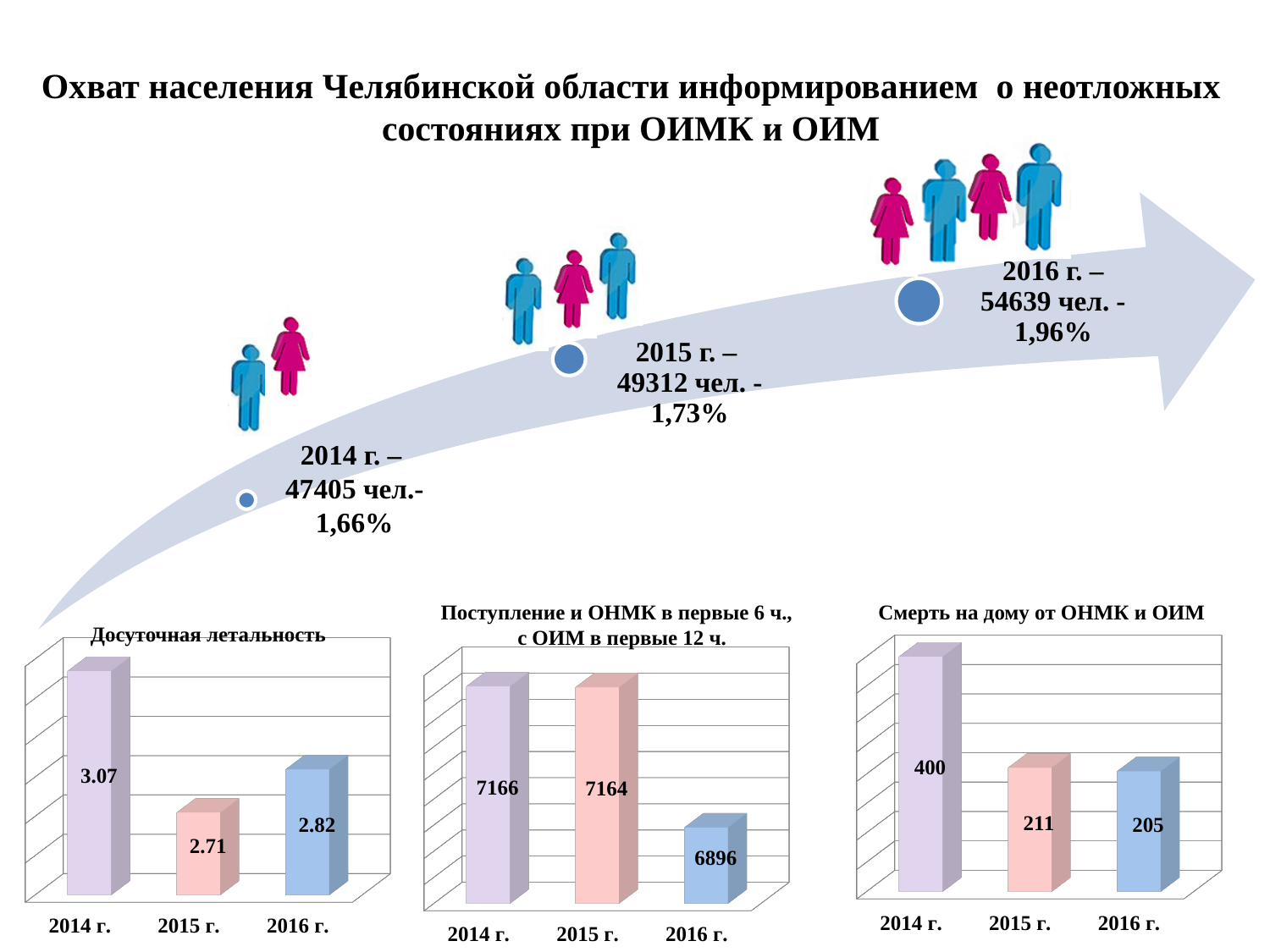
How many categories are shown in the chart titled "Досуточная летальность"? 3 In the chart titled "Досуточная летальность", what is the value for 2014 г.? 3.07 In the chart titled "Смерть на дому от ОНМК и ОИМ", which year has the highest value? 2014 г. In the chart titled "Досуточная летальность", what is the difference between the values for 2014 г. and 2016 г.? 0.25 In the chart titled "Смерть на дому от ОНМК и ОИМ", what is the value for 2015 г.? 211 In the chart titled "Досуточная летальность", which year has the lowest value? 2015 г. In the chart titled "Поступление и ОНМК в первые 6 ч., с ОИМ в первые 12 ч.", which year has the lowest value? 2016 г. In the chart titled "Поступление и ОНМК в первые 6 ч., с ОИМ в первые 12 ч.", what is the difference between the values for 2014 г. and 2016 г.? 270 In the chart titled "Смерть на дому от ОНМК и ОИМ", which is larger, the value for 2014 г. or the value for 2015 г.? 2014 г. In the chart titled "Смерть на дому от ОНМК и ОИМ", what is the difference between the values for 2014 г. and 2016 г.? 195 What kind of chart is the chart titled "Смерть на дому от ОНМК и ОИМ"? bar chart In the chart titled "Поступление и ОНМК в первые 6 ч., с ОИМ в первые 12 ч.", what is the value for 2016 г.? 6896